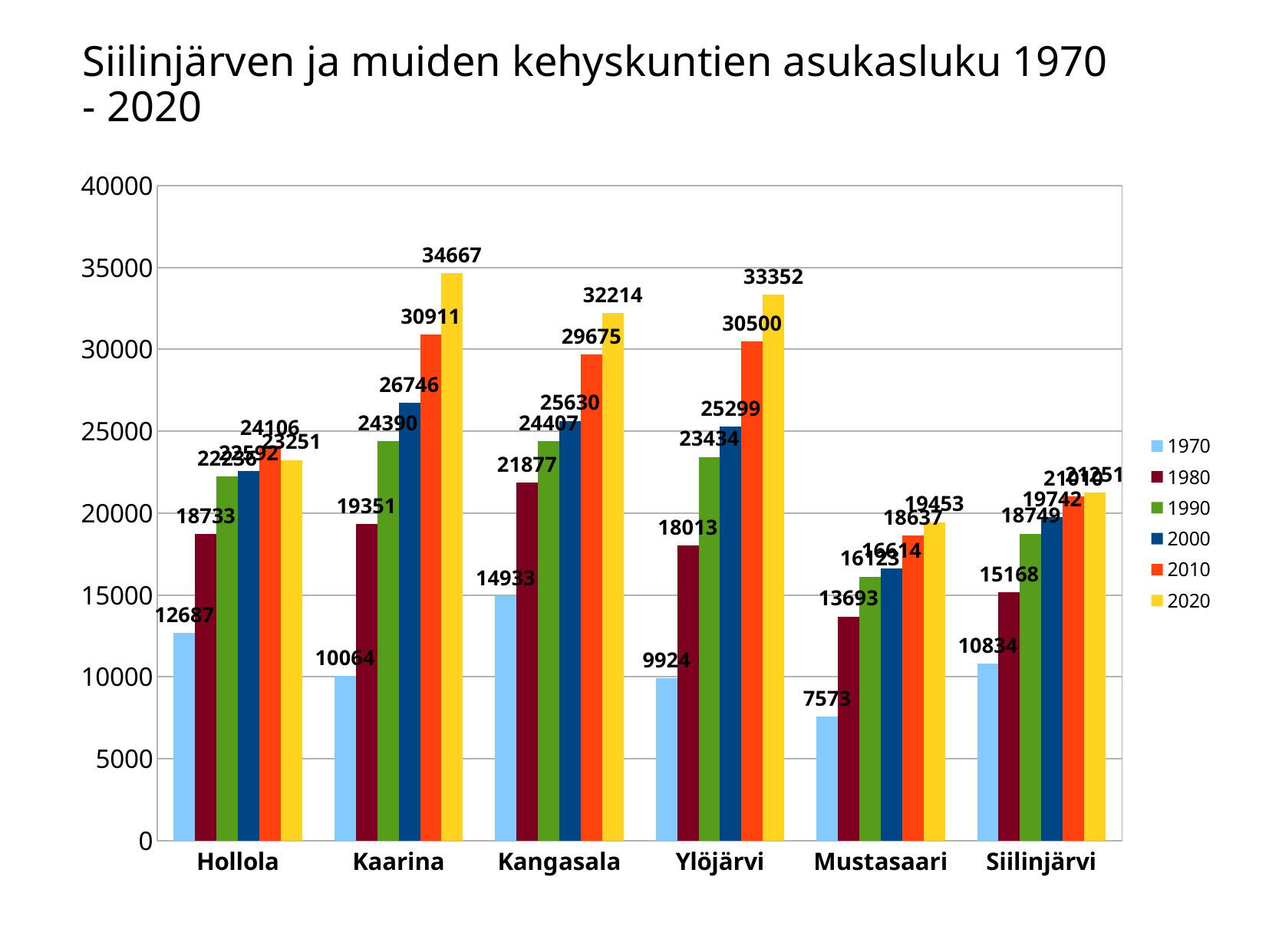
Do the values for Kaarina rise or fall from 1970 to 2020? rise What is the population value shown for Kaarina in 2020? 34667 Which municipality has the highest value for 2020? Kaarina Is the 2020 value for Mustasaari greater or less than 20000? less How many series does the legend list? 6 Which municipality has the lowest value for 1970? Mustasaari What kind of chart is shown on the slide? bar chart What is the value for Siilinjärvi in 1980? 15168 Which is larger: the 2010 value for Kaarina or the 2010 value for Ylöjärvi? Kaarina What is the value for Ylöjärvi in 1970? 9924 How many municipalities are shown on the x axis? 6 What is the difference between Kangasala's 2020 value and its 1970 value? 17281